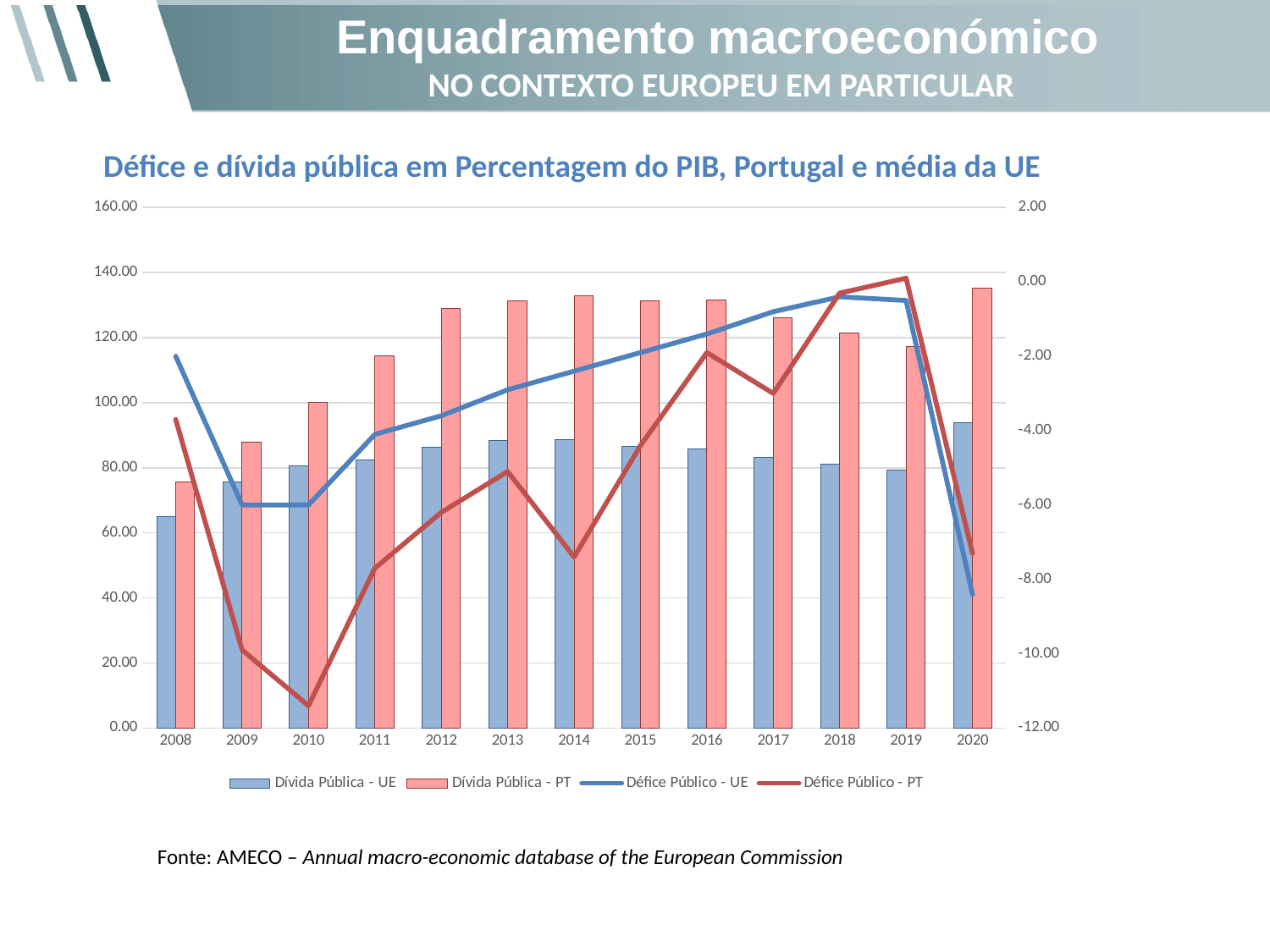
Is the value for Dívida Pública - PT in 2012 greater or less than 120? greater Which year has the lowest value for Dívida Pública - UE? 2008 In which year does the Défice Público - UE line reach its lowest point? 2020 How many years are shown on the x axis? 13 What kind of chart is shown on the slide? A combined bar and line chart Does the Dívida Pública - UE series rise or fall from 2008 to 2014? Rise How many series does the legend list? 4 Is the value for Dívida Pública - UE in 2020 greater or less than 80? greater In 2008, which is larger: Dívida Pública - PT or Dívida Pública - UE? Dívida Pública - PT In which year does the Défice Público - PT line reach its lowest point? 2010 Which year has the highest value for Dívida Pública - UE? 2020